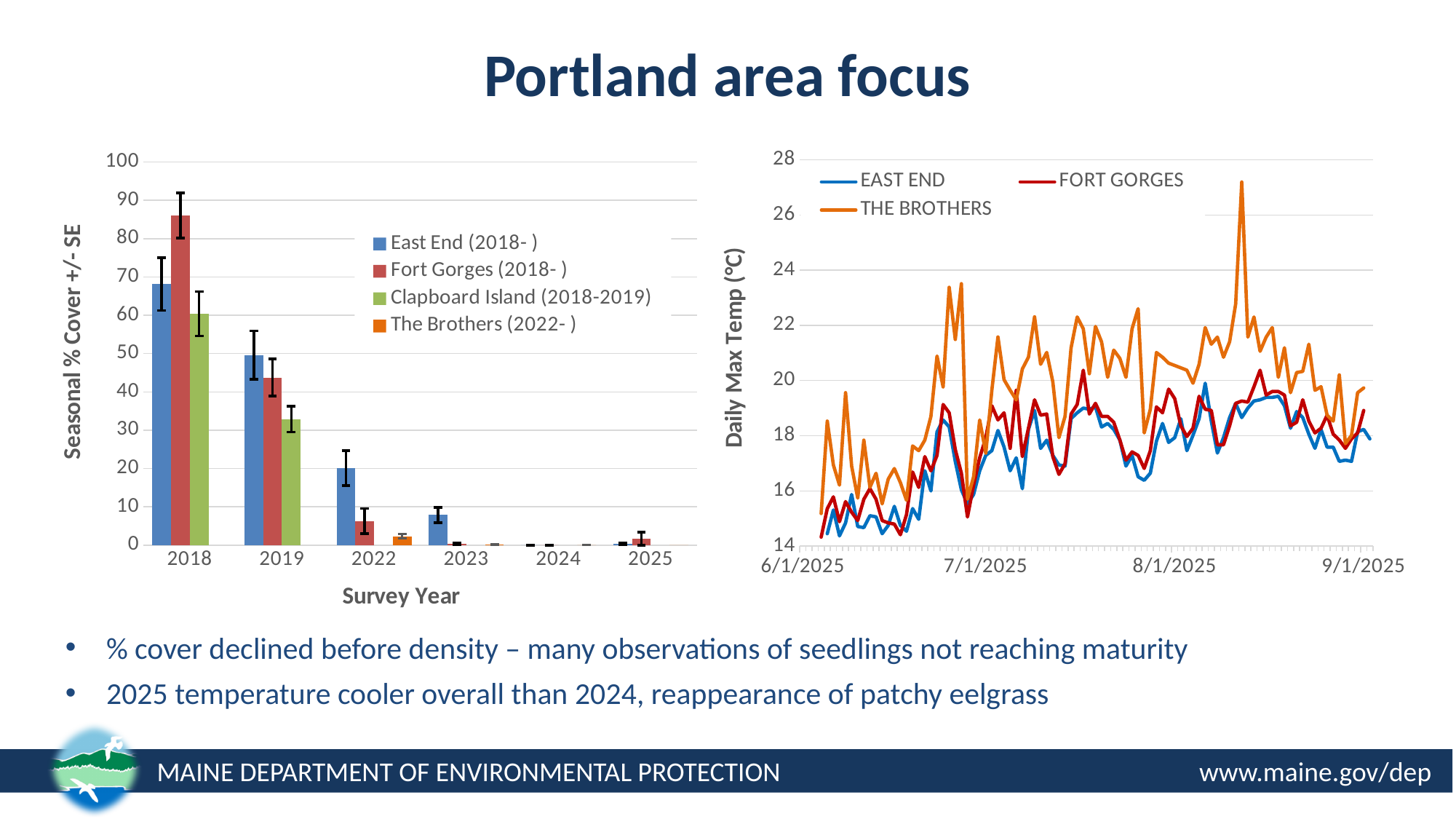
On the left chart (Seasonal % Cover), what kind of chart is it? bar chart On the left chart (Seasonal % Cover), which legend entry covers only 2018-2019? Clapboard Island (2018-2019) On the right chart (Daily Max Temp), what kind of chart is it? line chart On the right chart (Daily Max Temp), how many series does the legend list? 3 On the left chart (Seasonal % Cover), is the 2018 value for Fort Gorges greater or less than 80? greater On the left chart (Seasonal % Cover), how many survey years are shown on the x axis? 6 On the left chart (Seasonal % Cover), which site has the highest % cover in 2018? Fort Gorges On the right chart (Daily Max Temp), which series reaches the highest temperature? THE BROTHERS On the left chart (Seasonal % Cover), in 2019, which is larger: East End or Clapboard Island? East End On the left chart (Seasonal % Cover), is the 2019 value for Clapboard Island greater or less than 40? less On the left chart (Seasonal % Cover), do the East End values rise or fall across the survey years? fall On the left chart (Seasonal % Cover), how many series does the legend list? 4